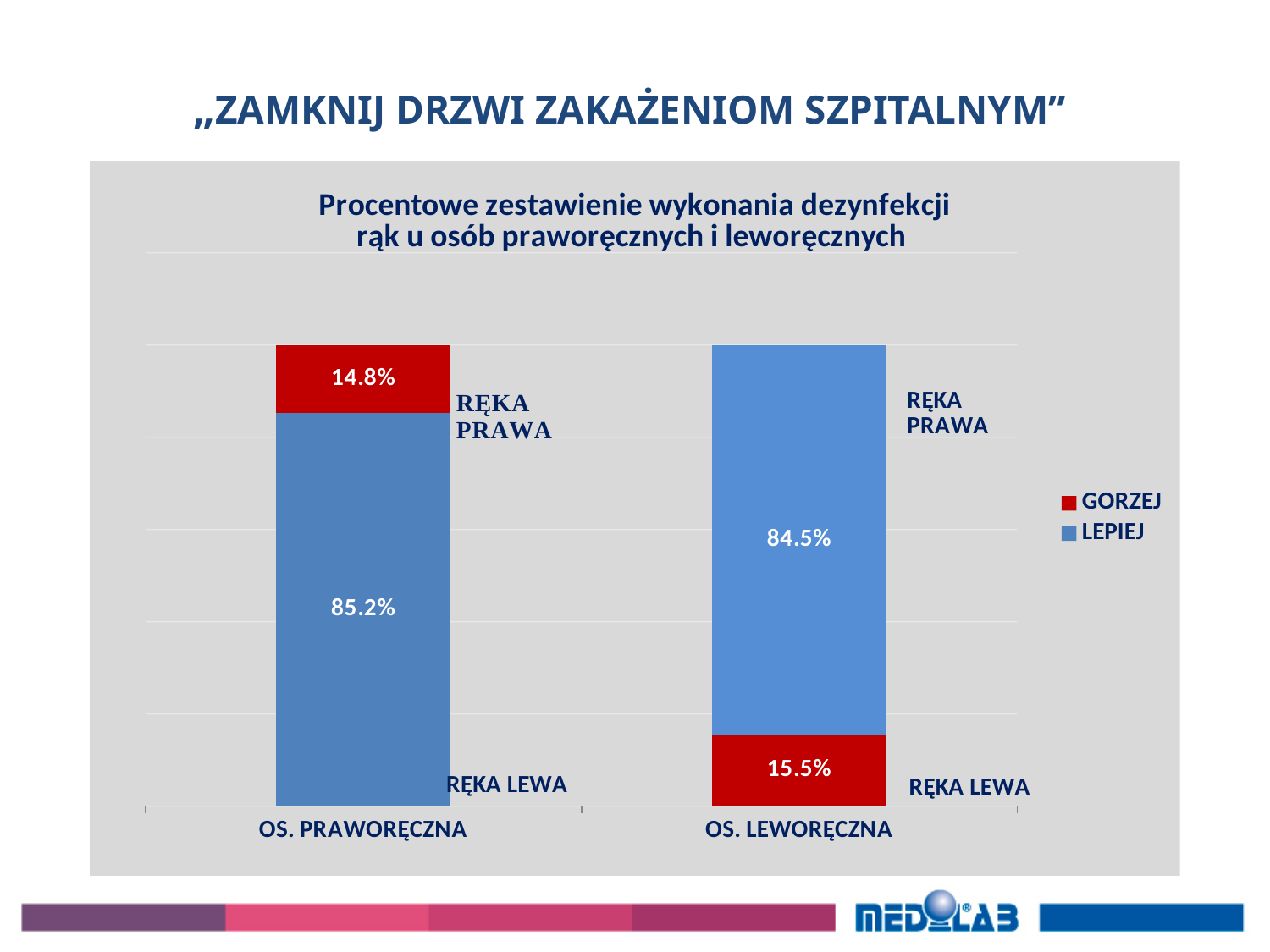
What is the difference between the LEPIEJ values for OS. PRAWORĘCZNA and OS. LEWORĘCZNA? 0.7% What is the value of GORZEJ for OS. LEWORĘCZNA? 15.5% Which category has the higher GORZEJ value? OS. LEWORĘCZNA Which is larger: LEPIEJ for OS. PRAWORĘCZNA or GORZEJ for OS. PRAWORĘCZNA? LEPIEJ for OS. PRAWORĘCZNA What is the value of GORZEJ for OS. PRAWORĘCZNA? 14.8% What is the value of LEPIEJ for OS. LEWORĘCZNA? 84.5% What is the value of LEPIEJ for OS. PRAWORĘCZNA? 85.2% How many categories are shown on the x axis? 2 What kind of chart is shown on the slide? Stacked bar chart Which category has the lower LEPIEJ value? OS. LEWORĘCZNA What is the total of the stacked bar for OS. LEWORĘCZNA? 100% How many series does the legend list? 2